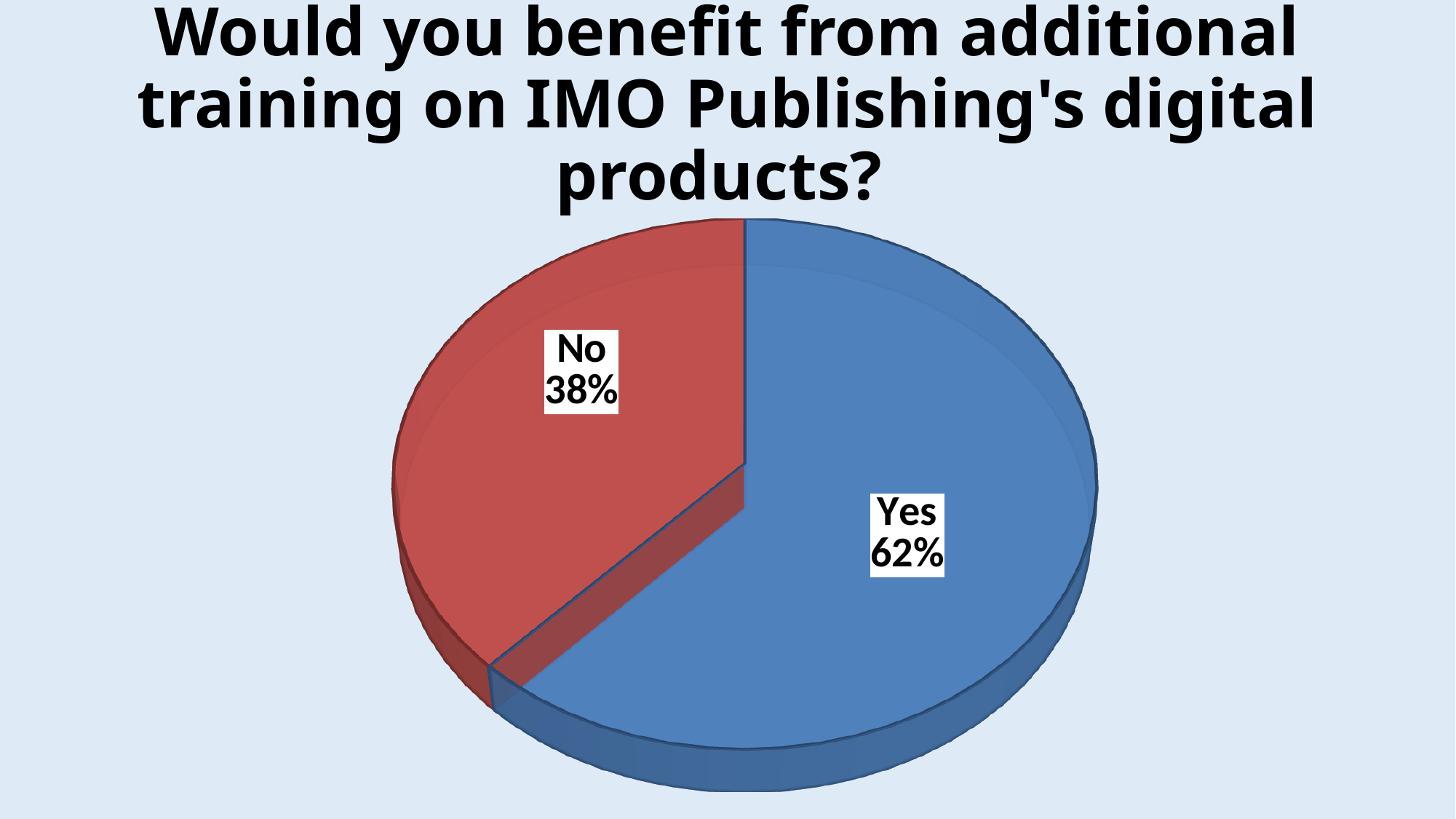
What share of the pie does the Yes slice represent? 62% Which is larger, the share for Yes or the share for No? Yes What percentage of respondents answered Yes? 62% What is the difference in percentage points between the Yes and No shares? 24 What colour is the Yes slice? blue What is the title of the chart? Would you benefit from additional training on IMO Publishing's digital products? How many slices does the pie chart have? 2 Which response has the largest share of the pie? Yes What percentage of respondents answered No? 38% What kind of chart is shown on the slide? pie chart Which response has the smallest share of the pie? No